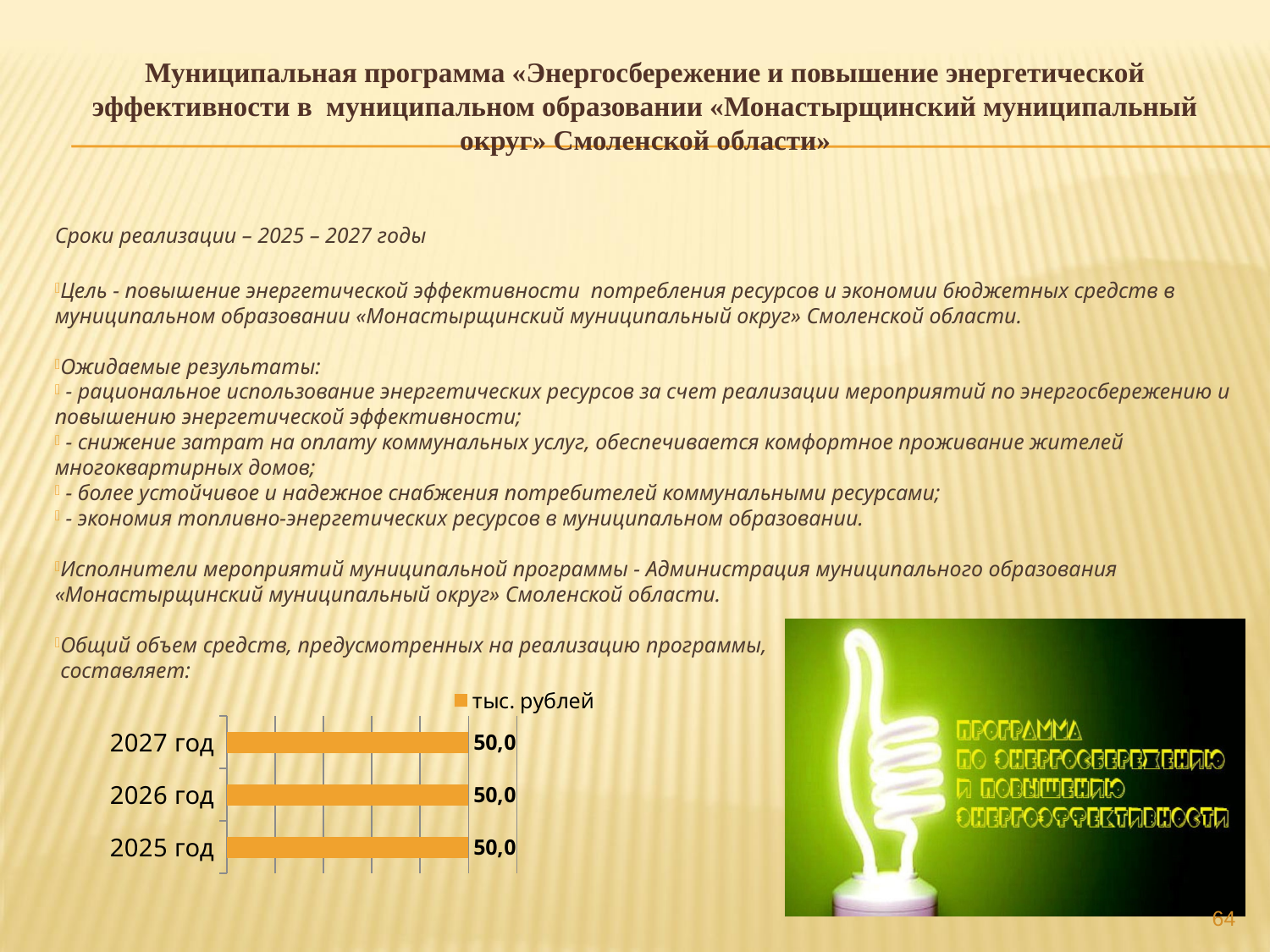
What is the value for 2027 год in the chart? 50,0 What is the name of the series shown in the chart legend? тыс. рублей What is the value for 2026 год in the chart? 50,0 How many series does the chart legend list? 1 How many categories (years) are shown in the chart? 3 What kind of chart is shown on the slide? bar chart What is the value for 2025 год in the chart? 50,0 Do the values rise, fall, or stay the same from 2025 год to 2027 год? stay the same What is the difference between the values for 2027 год and 2025 год? 0,0 What colour are the bars in the chart? orange